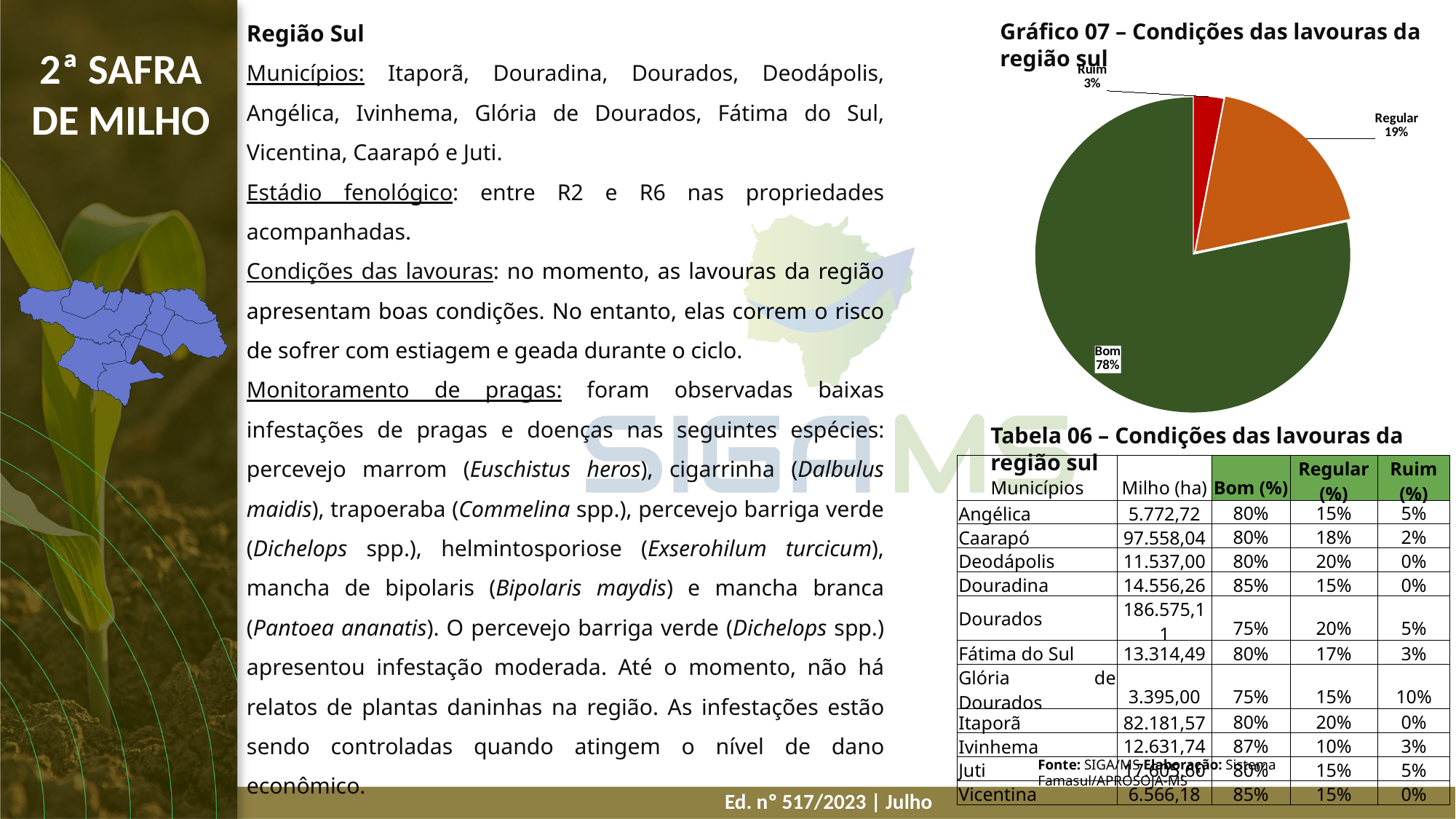
In Gráfico 07, what colour is the 'Bom' slice? dark green What kind of chart is Gráfico 07? pie chart In Gráfico 07, what percentage is shown for 'Ruim'? 3% In Gráfico 07, what percentage is shown for 'Regular'? 19% In Gráfico 07, what share of the crops is in the 'Bom' condition? 78% In Gráfico 07, what is the difference between the 'Regular' and 'Ruim' shares? 16% How many slices does the pie chart in Gráfico 07 have? 3 In Gráfico 07, which is larger: the 'Regular' slice or the 'Ruim' slice? Regular What is the title of the pie chart on the slide? Gráfico 07 – Condições das lavouras da região sul Which category has the largest slice in Gráfico 07? Bom In Gráfico 07, how many percentage points larger is 'Bom' than 'Regular'? 59 Which category has the smallest slice in Gráfico 07? Ruim